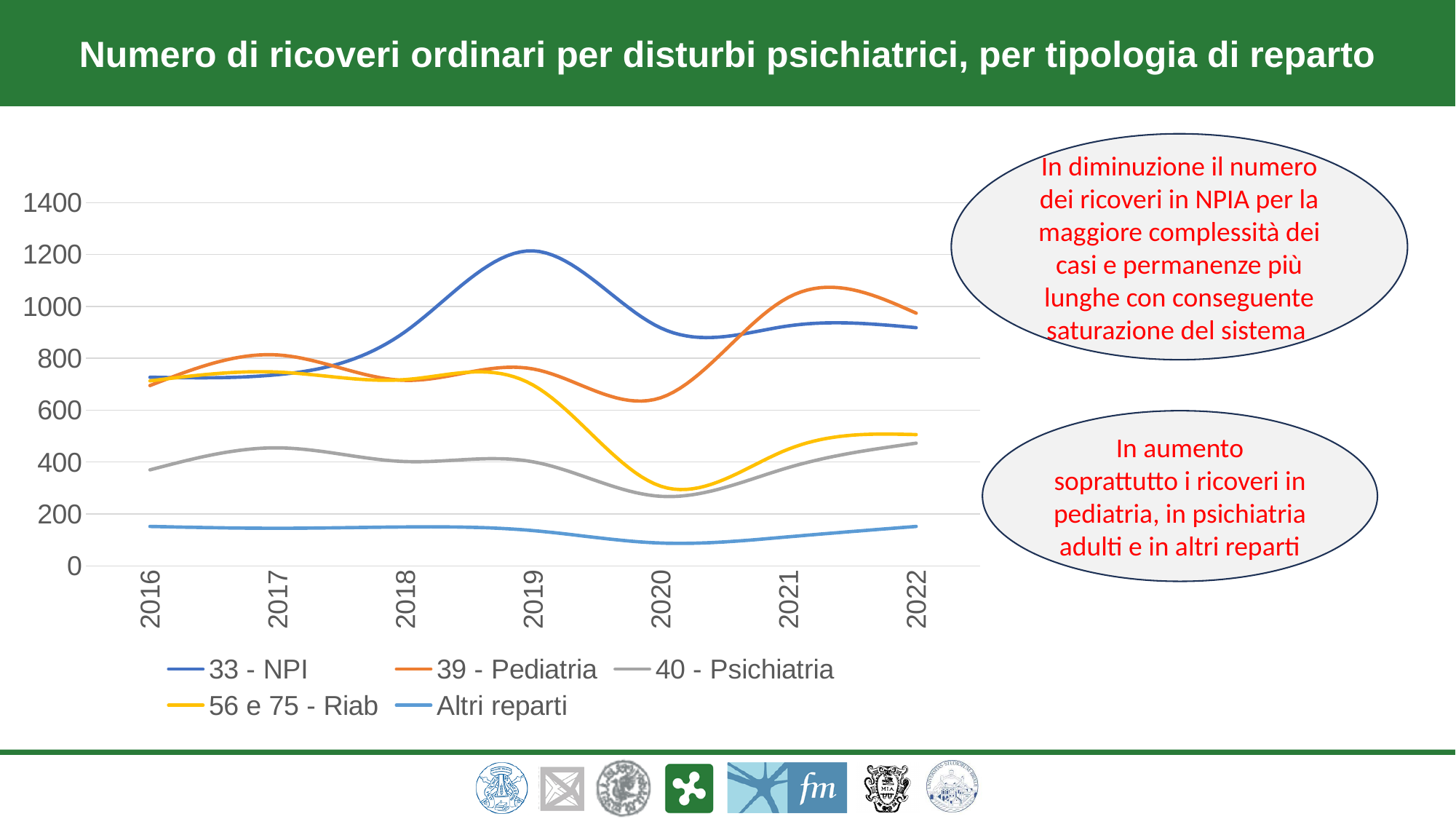
Which series has the highest value in 2019? 33 - NPI Is the value for 33 - NPI in 2019 greater or less than 1000? greater Which series has the lowest value in 2022? Altri reparti In 2022, which is larger: 39 - Pediatria or 33 - NPI? 39 - Pediatria Does the 56 e 75 - Riab series rise or fall between 2019 and 2020? fall In 2016, which is larger: 40 - Psichiatria or Altri reparti? 40 - Psichiatria What kind of chart is shown on the slide? line chart Is the value for 40 - Psichiatria in 2020 greater or less than 400? less How many series does the legend list? 5 How many years are shown on the x axis? 7 Is the value for Altri reparti in 2020 greater or less than 200? less In which year does the 33 - NPI series reach its peak? 2019